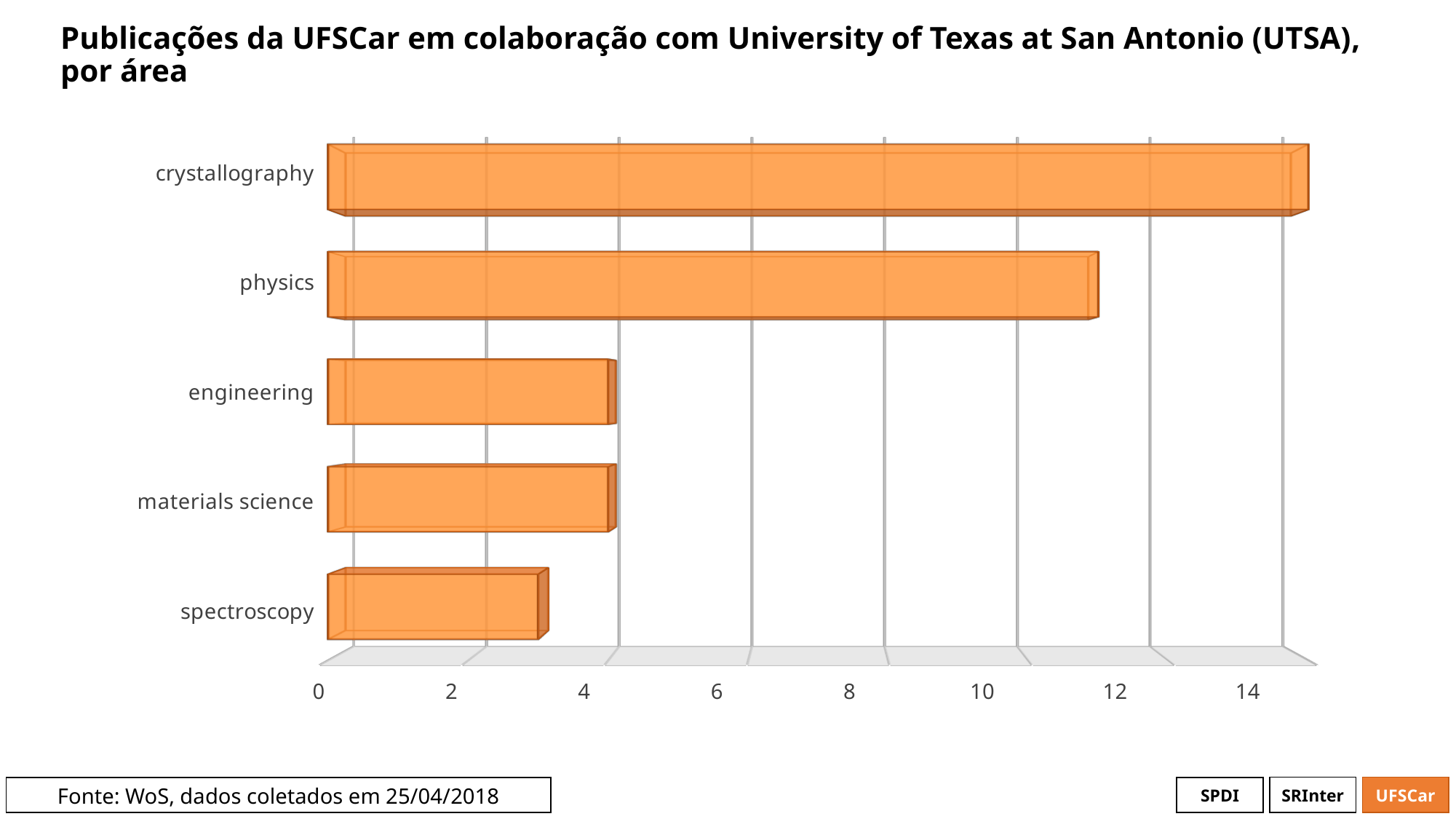
Is the value for physics greater or less than 10? greater Which has more publications, physics or engineering? physics Is the value for materials science greater or less than 2? greater Which area has the highest number of publications? crystallography Which has more publications, spectroscopy or crystallography? crystallography Is the value for spectroscopy greater or less than 4? less How many areas (categories) are plotted in the chart? 5 What kind of chart is shown on the slide? bar chart Which area has the lowest number of publications? spectroscopy What is the data source cited at the bottom of the slide? WoS, dados coletados em 25/04/2018